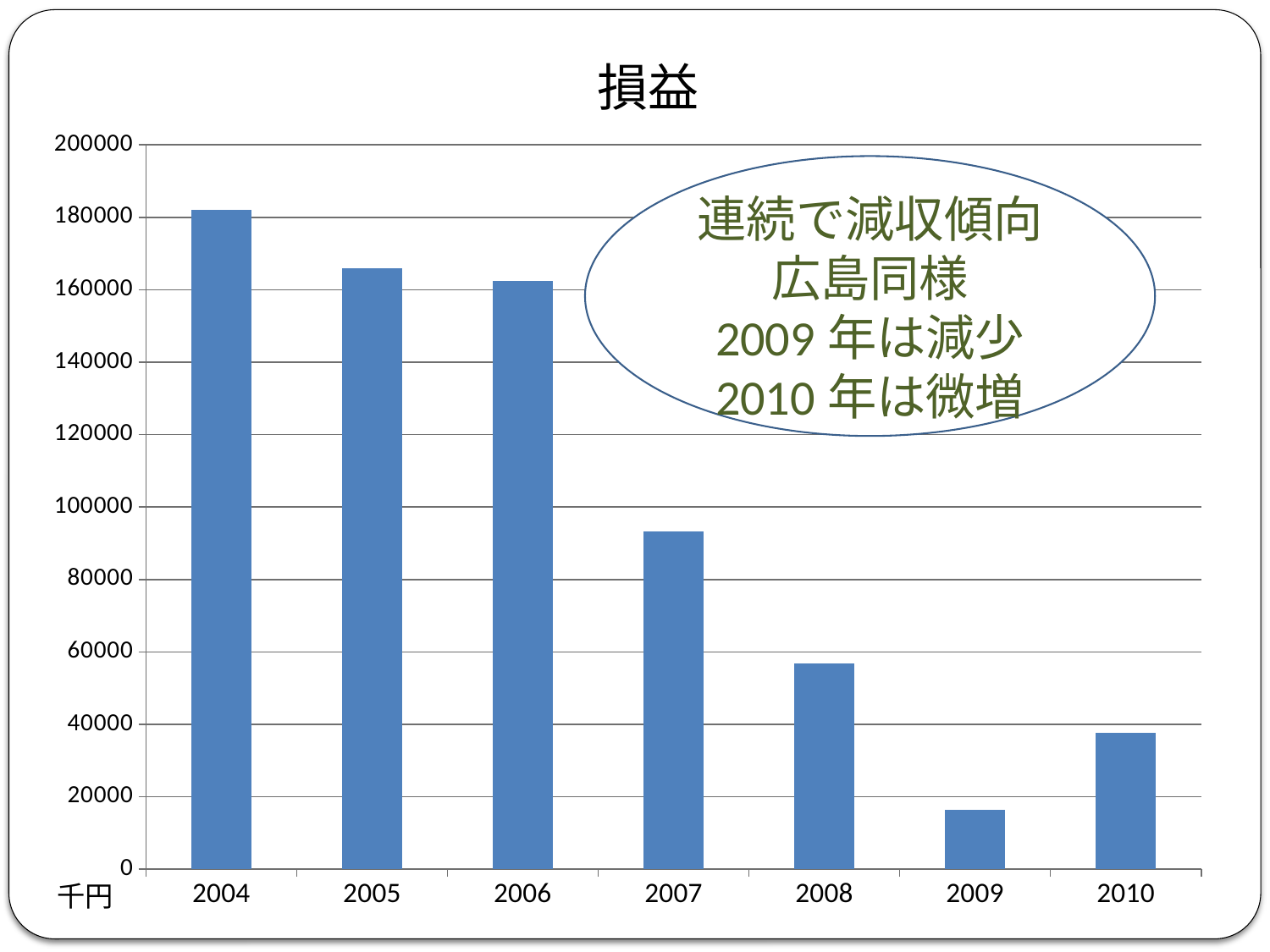
Is the value for 2010 greater or less than 20000? greater What kind of chart is shown on the slide? bar chart Do the values generally rise or fall from 2004 to 2009? fall Which year has the larger value, 2008 or 2010? 2008 Is the value for 2009 greater or less than 20000? less Is the value for 2007 greater or less than 100000? less What is the title of the chart? 損益 What unit label is shown at the bottom left of the chart's vertical axis? 千円 How many years are shown on the x axis of the chart? 7 Which year has the lowest value in the chart? 2009 Which year has the highest value in the chart? 2004